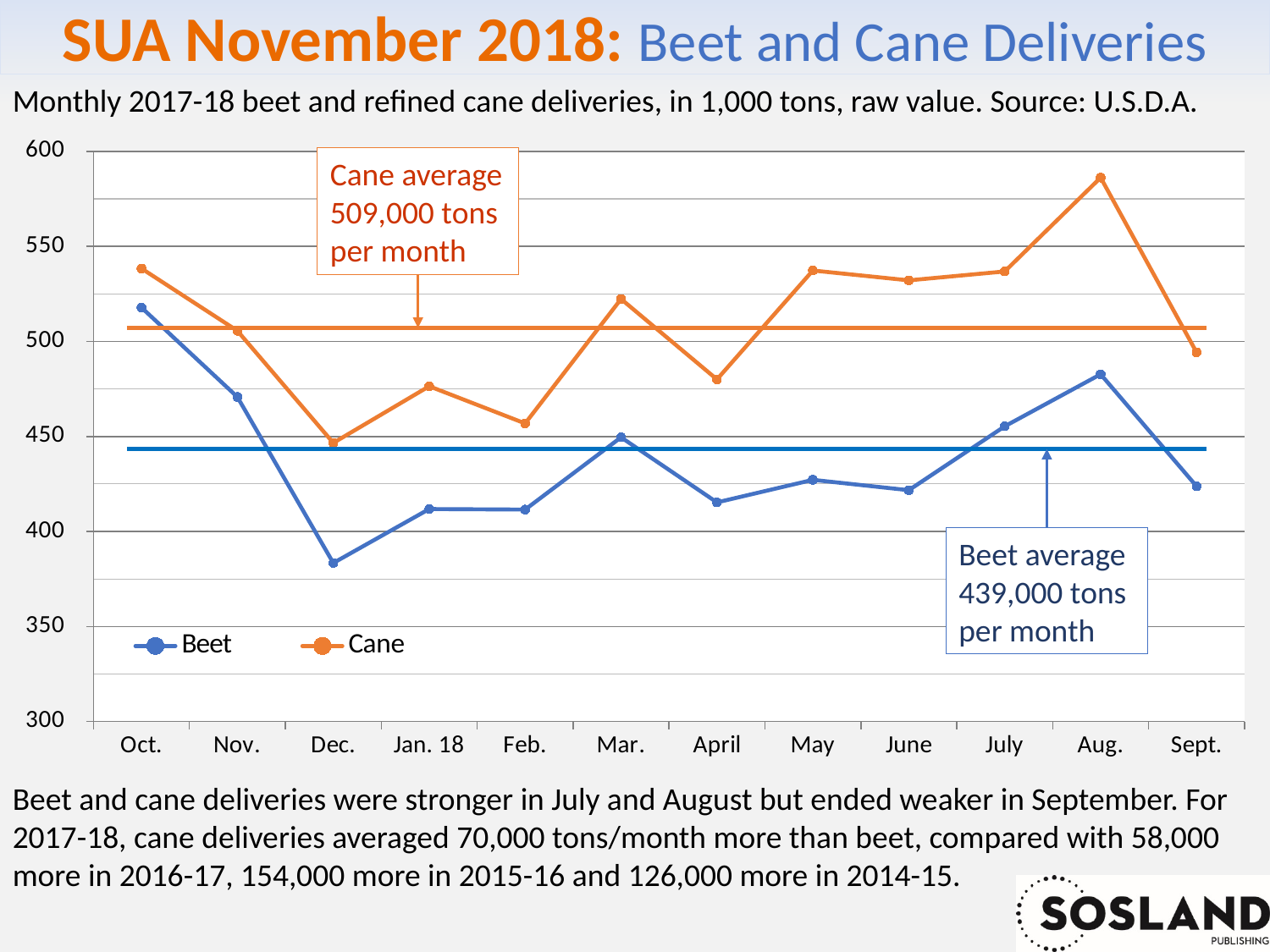
How many series does the legend list? 2 In which month is the Cane series at its lowest? Dec. Is the Beet value for Oct. greater or less than 500? greater Is the Beet value for Dec. greater or less than 400? less According to the annotation, what is the Cane average per month? 509,000 tons Is the Cane value for Aug. greater or less than 550? greater Which series has the larger value in Oct., Beet or Cane? Cane In which month is the Cane series at its highest? Aug. In which month is the Beet series at its lowest? Dec. What kind of chart is shown on the slide? line chart Does the Beet series rise or fall from Oct. to Dec.? fall How many months are plotted along the x axis? 12